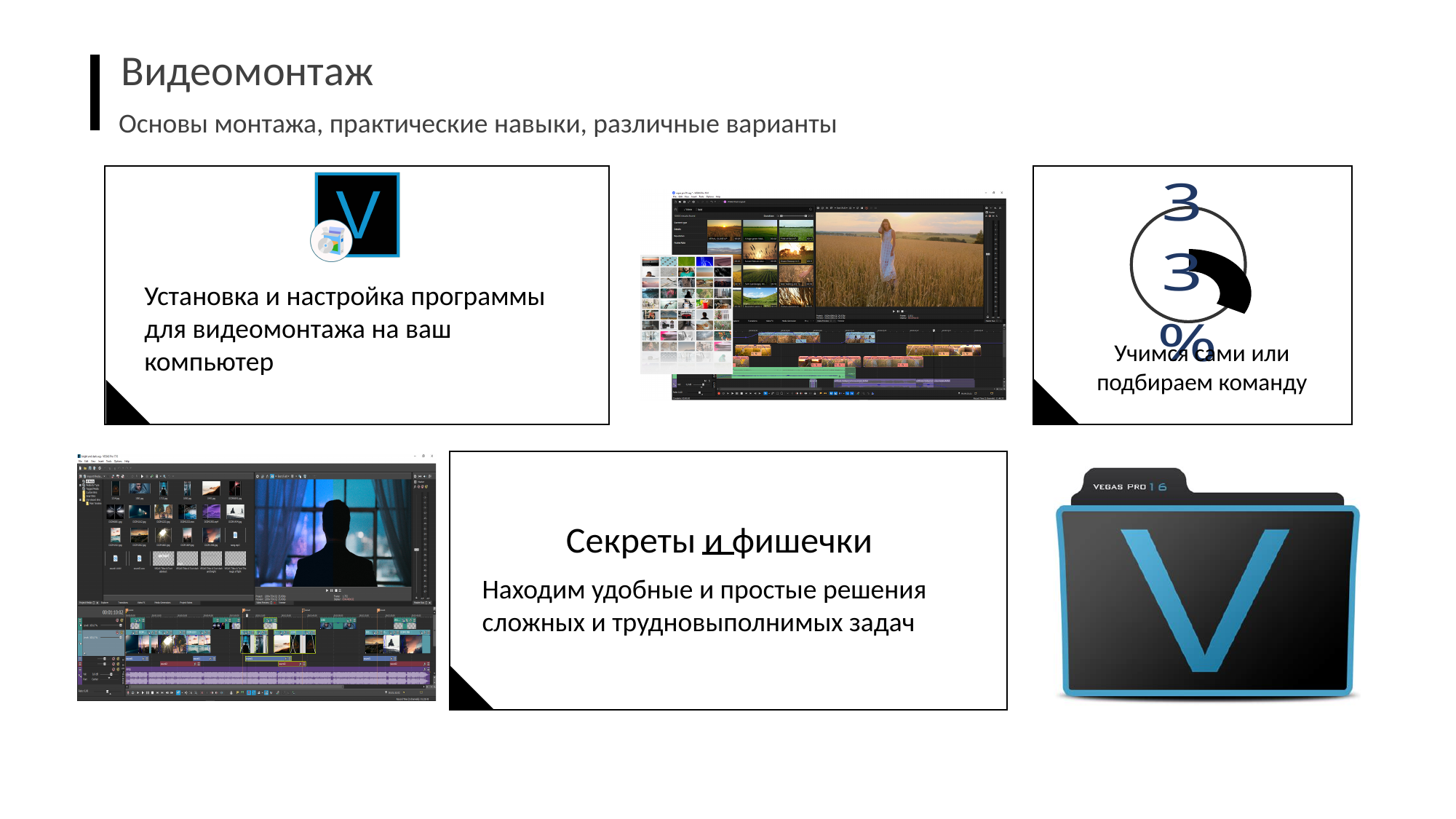
What kind of chart is shown in the top-right box next to the text "Учимся сами или подбираем команду"? doughnut chart Is the filled share shown on the doughnut chart in the top-right box greater or less than 50%? less What colour is the filled segment of the doughnut chart in the top-right box? black What percentage value is printed on the doughnut chart in the top-right box? 33%